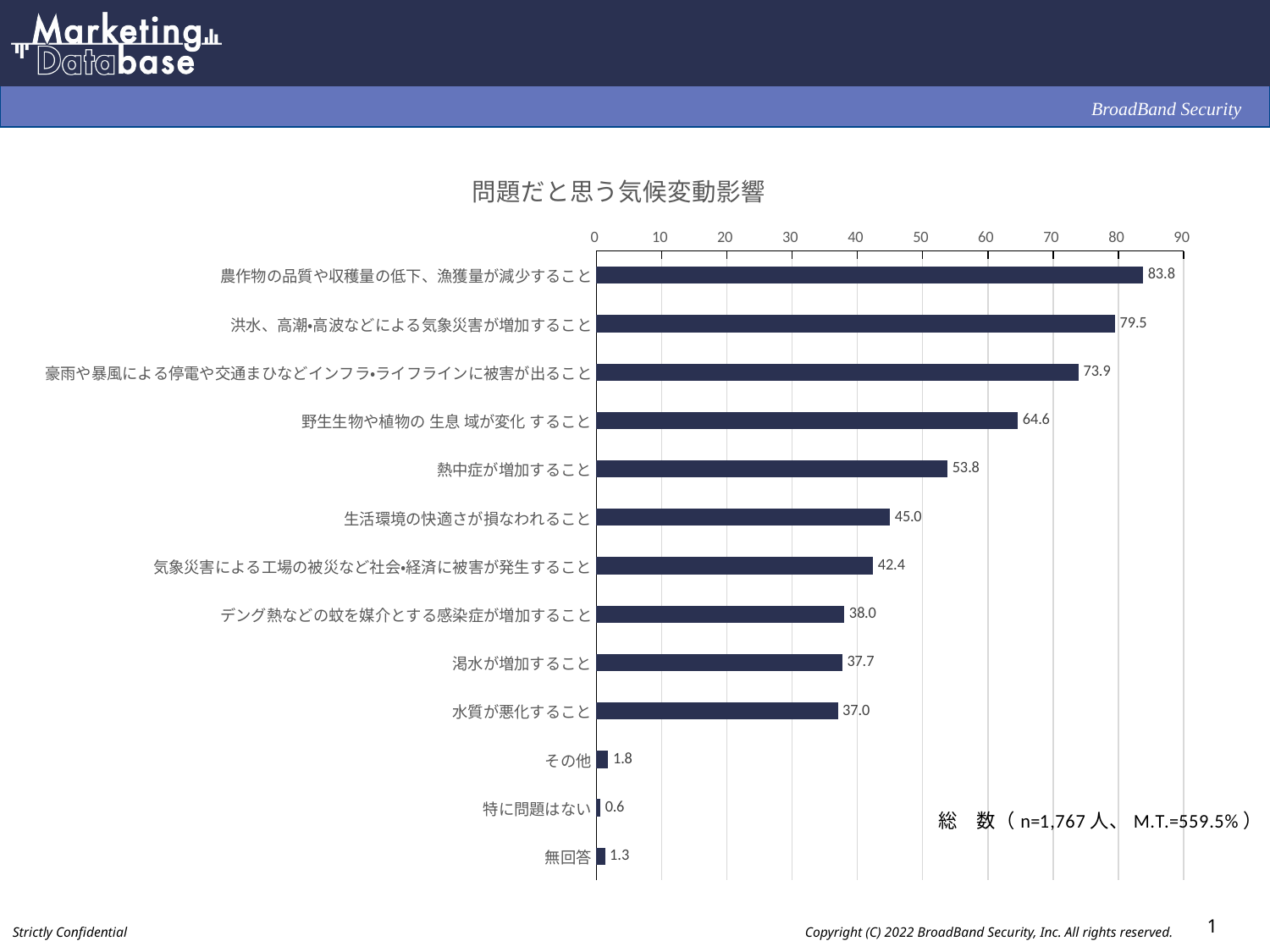
What is the value for 渇水が増加すること? 37.7 Which is larger, the value for 生活環境の快適さが損なわれること or the value for 気象災害による工場の被災など社会•経済に被害が発生すること? 生活環境の快適さが損なわれること What is the difference between the values for 洪水、高潮•高波などによる気象災害が増加すること and 豪雨や暴風による停電や交通まひなどインフラ•ライフラインに被害が出ること? 5.6 What is the value for 熱中症が増加すること? 53.8 What kind of chart is shown on the slide? bar chart How many categories are shown in the chart? 13 Which category has the highest value? 農作物の品質や収穫量の低下、漁獲量が減少すること Is the value for デング熱などの蚊を媒介とする感染症が増加すること greater or less than 40? less What is the title of the chart? 問題だと思う気候変動影響 Which category has the lowest value? 特に問題はない What is the value for 野生生物や植物の生息域が変化すること? 64.6 What is the value for 無回答? 1.3